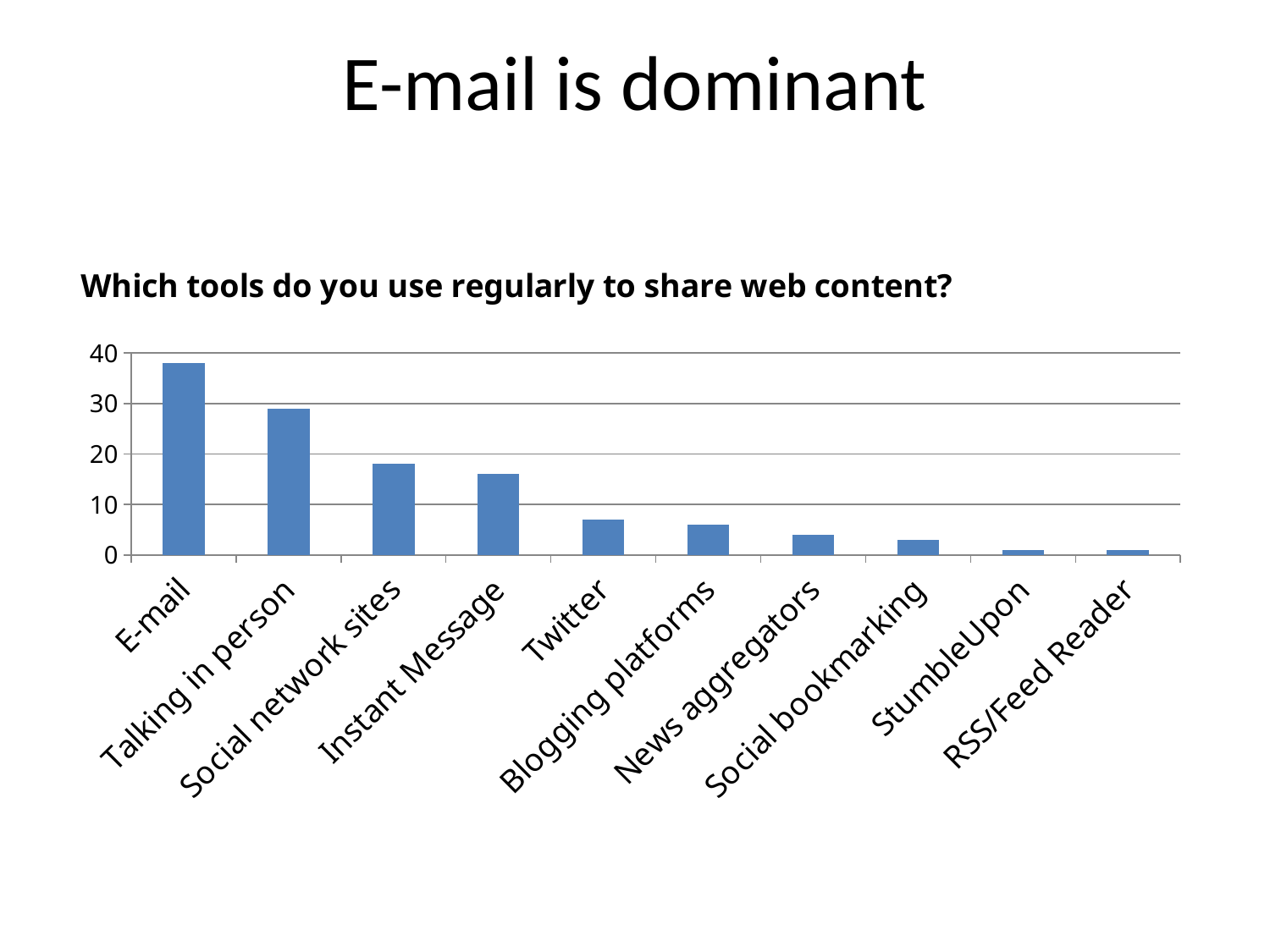
Which is larger, the value for Talking in person or the value for Social network sites? Talking in person Is the value for E-mail greater or less than 30? greater Is the value for Instant Message greater or less than 20? less Which tool has the highest value in the chart? E-mail Is the value for Twitter greater or less than 10? less How many tools (categories) are shown on the x axis of the chart? 10 Which is larger, the value for Twitter or the value for Social bookmarking? Twitter Do the values rise or fall moving from left to right along the x axis? fall What is the title of the chart? Which tools do you use regularly to share web content? What kind of chart is shown on the slide? bar chart